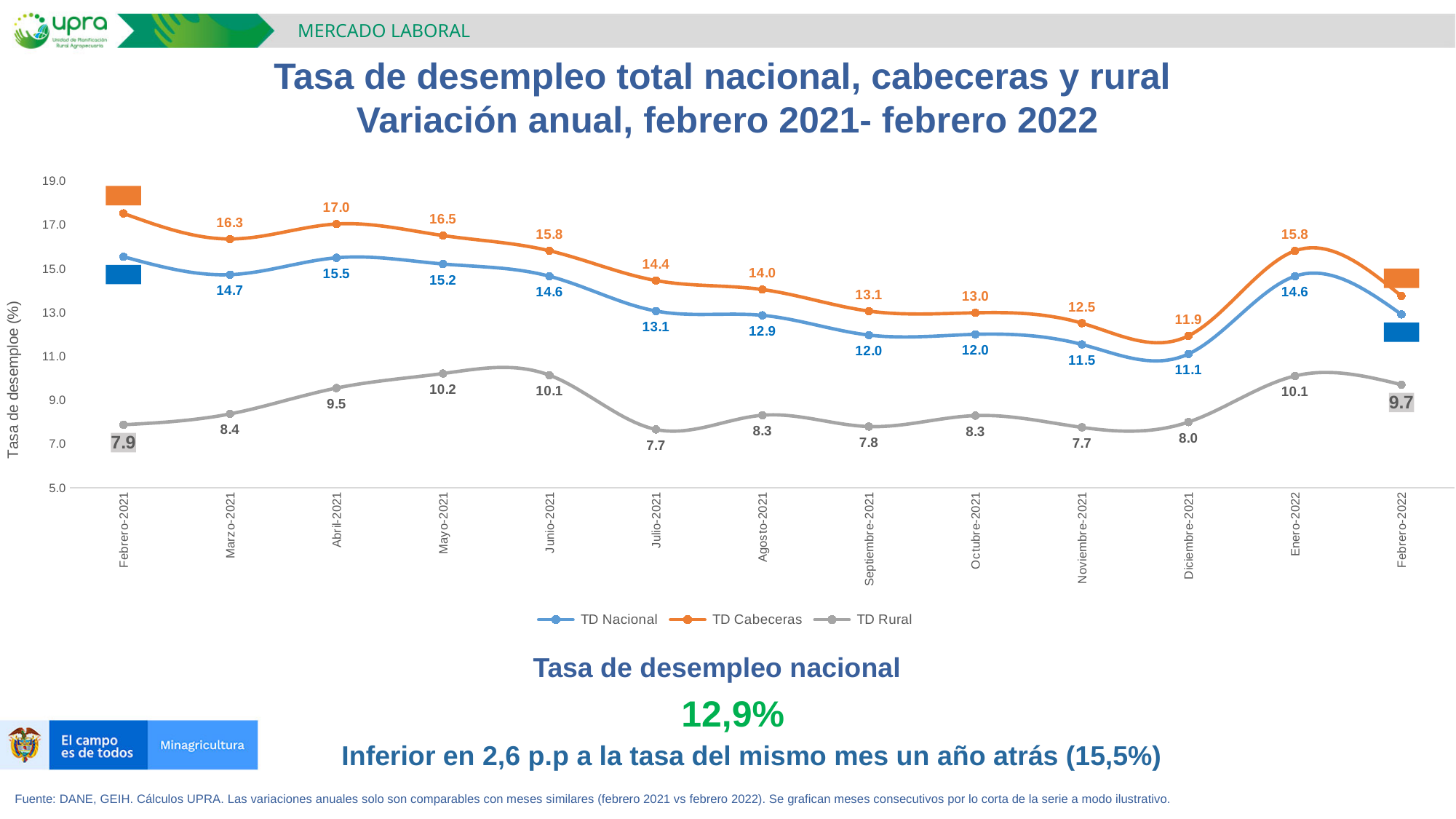
What kind of chart is shown on the slide? line chart Is the value for TD Cabeceras in Febrero-2021 greater or less than 17.0? greater What is the value of TD Nacional in Diciembre-2021? 11.1 What is the difference between TD Cabeceras and TD Nacional in Abril-2021? 1.5 How many months are plotted on the x axis? 13 How many series does the legend list? 3 In which month does TD Nacional reach its lowest value? Diciembre-2021 What is the value of TD Cabeceras in Abril-2021? 17.0 By how much did TD Cabeceras rise from Diciembre-2021 to Enero-2022? 3.9 Which is larger for TD Rural: Abril-2021 or Junio-2021? Junio-2021 In which month does TD Rural reach its highest value? Mayo-2021 What is the value of TD Rural in Mayo-2021? 10.2